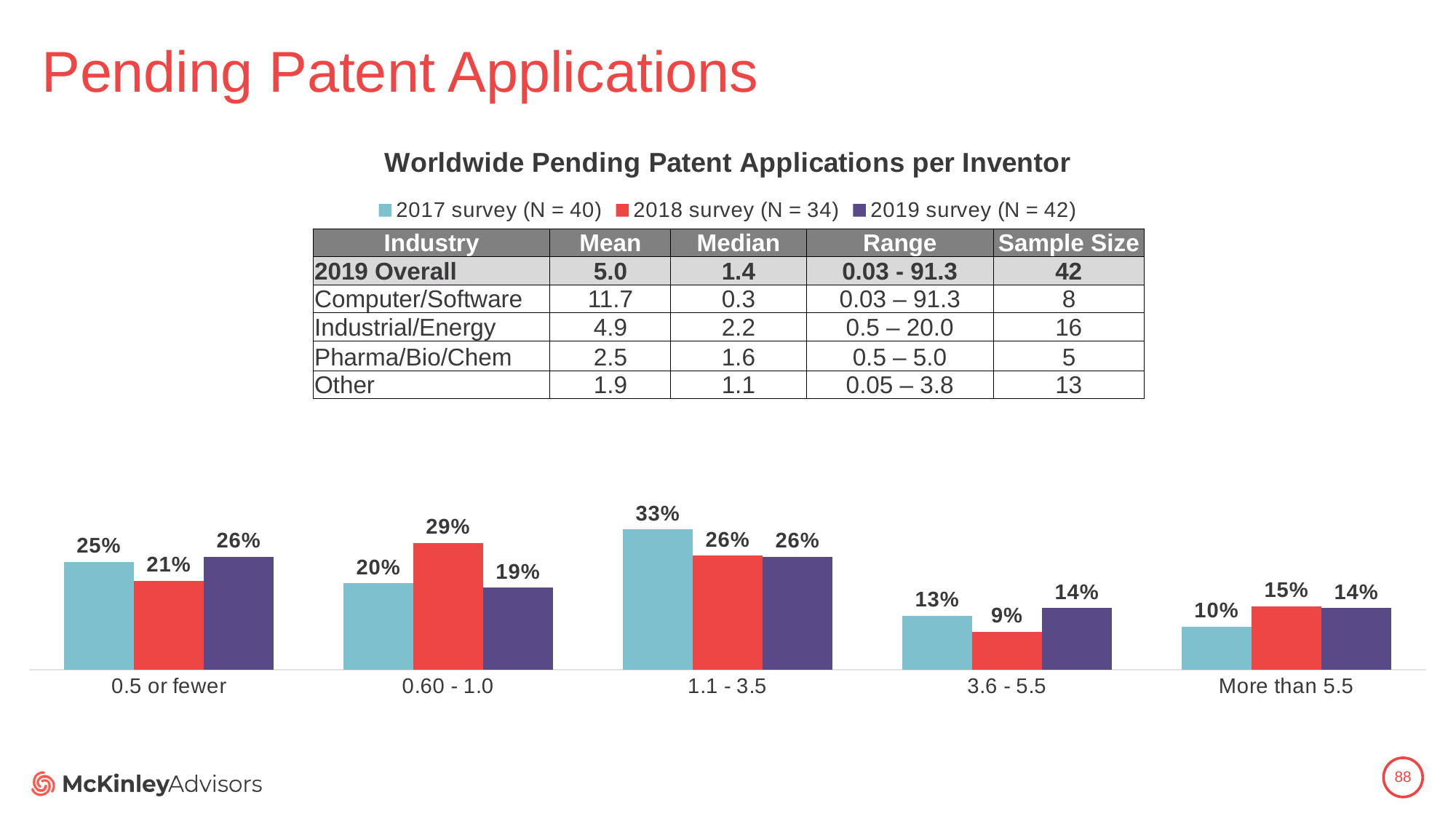
What is the value for the 2018 survey in the '3.6 - 5.5' category? 9% What kind of chart is shown on the slide? Bar chart What is the value for the 2019 survey in the '0.5 or fewer' category? 26% What is the value for the 2018 survey in the 'More than 5.5' category? 15% Which category has the lowest value for the 2018 survey? 3.6 - 5.5 What is the value for the 2017 survey in the '1.1 - 3.5' category? 33% Which category has the highest value for the 2017 survey? 1.1 - 3.5 What is the title of the chart? Worldwide Pending Patent Applications per Inventor What is the difference between the 2018 survey and 2019 survey values in the '0.60 - 1.0' category? 10% How many series does the chart legend list? 3 Which is larger in the '0.5 or fewer' category: the 2017 survey value or the 2018 survey value? 2017 survey How many categories are shown on the x axis of the chart? 5